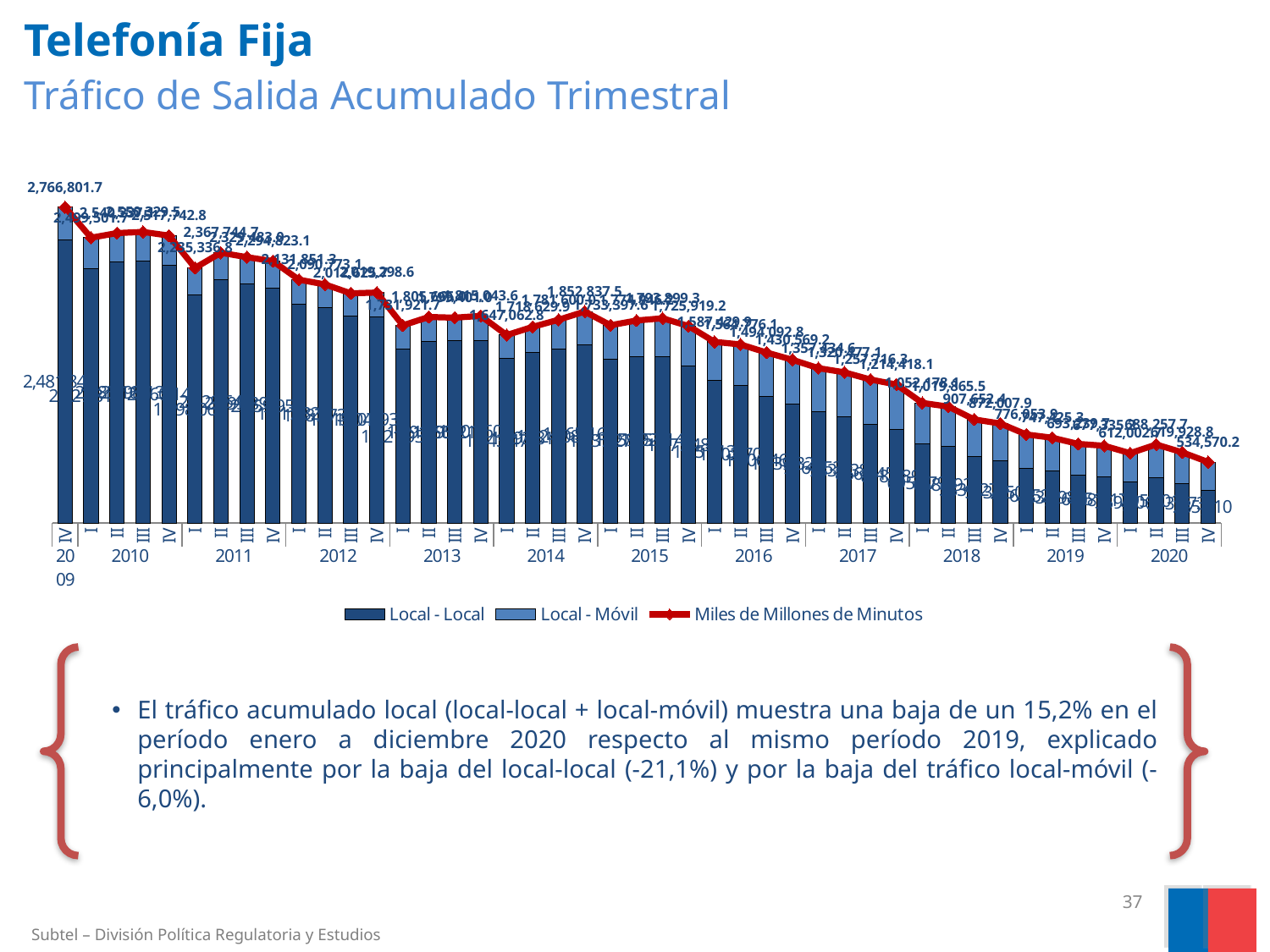
What is the value of the Miles de Millones de Minutos line for IV 2009, the first point on the chart? 2,766,801.7 What kind of chart is shown on the slide? Stacked bar chart with a line overlay What is the value of the Miles de Millones de Minutos line for IV 2020, the last point on the chart? 534,570.2 Which quarter has the highest value on the Miles de Millones de Minutos line? IV 2009 What colour is the Miles de Millones de Minutos line in the chart? Red What is the difference between the Miles de Millones de Minutos values for IV 2009 (2,766,801.7) and IV 2020 (534,570.2)? 2,232,231.5 What is the title of the chart? Tráfico de Salida Acumulado Trimestral How many series does the legend list? 3 How many years are labelled on the x axis of the chart? 12 Do the values of the Miles de Millones de Minutos line generally rise or fall from 2009 to 2020? Fall Which quarter has the lowest value on the Miles de Millones de Minutos line? IV 2020 Which is larger, the Miles de Millones de Minutos value for IV 2009 or for IV 2020? IV 2009